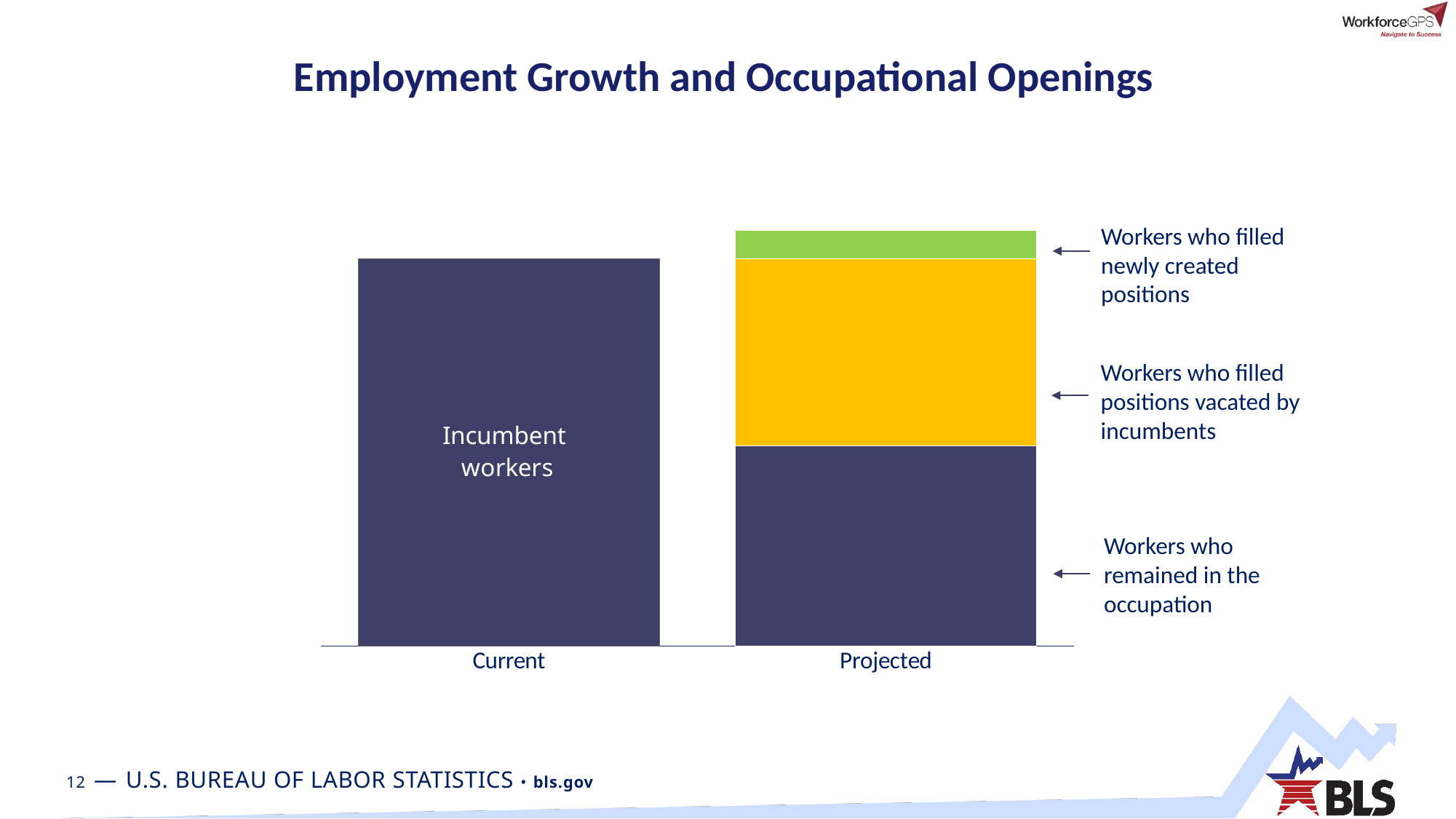
What label is printed inside the Current bar? Incumbent workers What is the title of the chart? Employment Growth and Occupational Openings Do the bar heights rise or fall from Current to Projected? Rise Which segment of the Projected bar is the smallest? Workers who filled newly created positions How many segments make up the Projected bar? 3 What kind of chart is shown on the slide? Bar chart What are the two categories labelled on the x axis? Current and Projected How many categories are shown on the x axis of the chart? 2 Which segment of the Projected bar is the largest? Workers who remained in the occupation Which segment of the Projected bar is larger: workers who filled positions vacated by incumbents or workers who filled newly created positions? Workers who filled positions vacated by incumbents Which bar is taller, Current or Projected? Projected